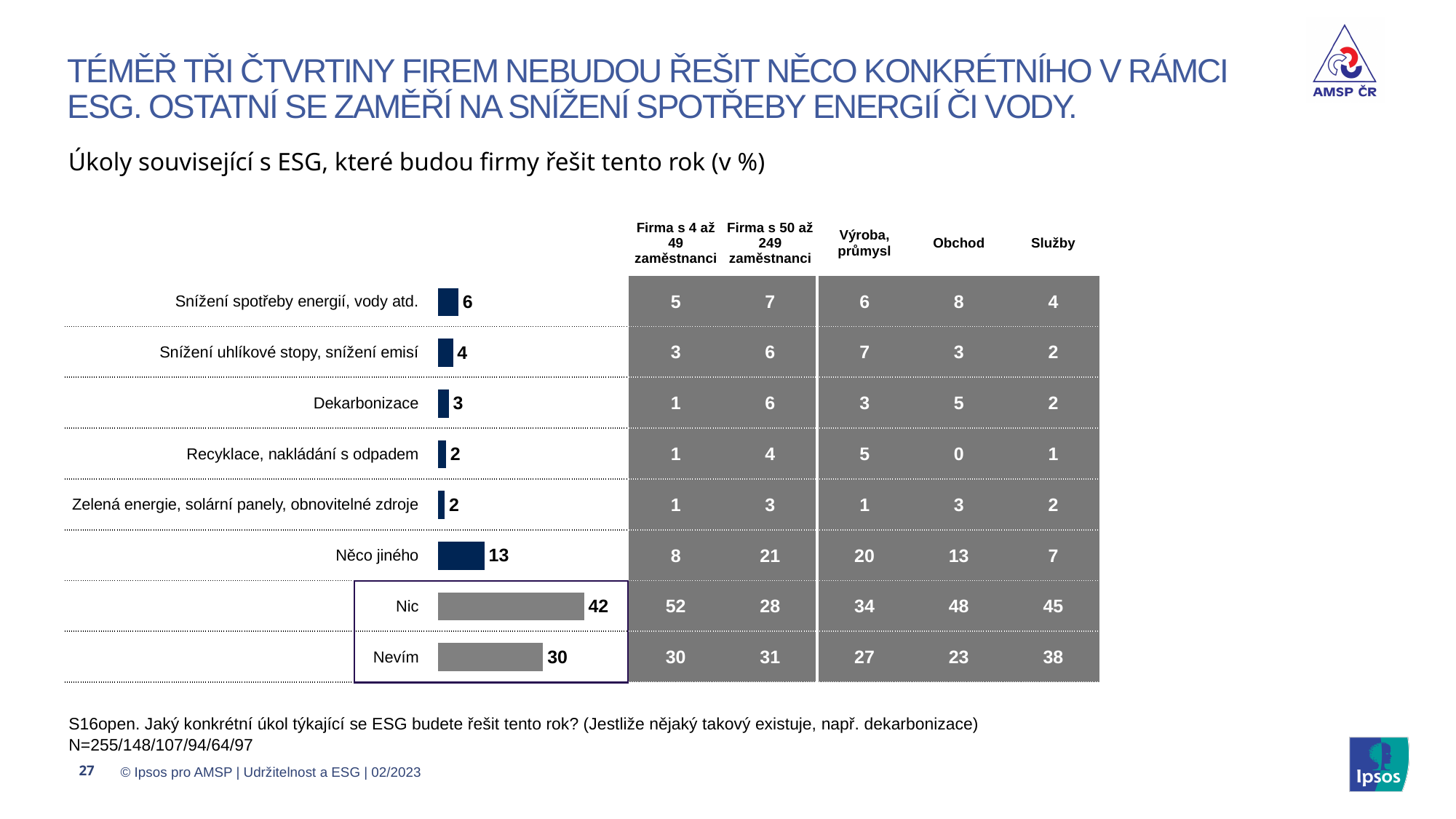
What is the difference between the values for "Nic" and "Nevím" in the bar chart? 12 What is the value for "Nevím" in the bar chart? 30 Which is larger in the bar chart: the value for "Něco jiného" or the value for "Snížení uhlíkové stopy, snížení emisí"? Něco jiného What is the value for "Dekarbonizace" in the bar chart? 3 What is the value for "Něco jiného" in the bar chart? 13 What kind of chart is shown on the slide? bar chart What is the value for "Snížení spotřeby energií, vody atd." in the bar chart? 6 What is the title of the chart on the slide? Úkoly související s ESG, které budou firmy řešit tento rok (v %) What is the difference between the values for "Snížení spotřeby energií, vody atd." and "Snížení uhlíkové stopy, snížení emisí" in the bar chart? 2 Which category has the highest value in the bar chart? Nic How many categories does the bar chart show? 8 What is the value for "Nic" in the bar chart? 42